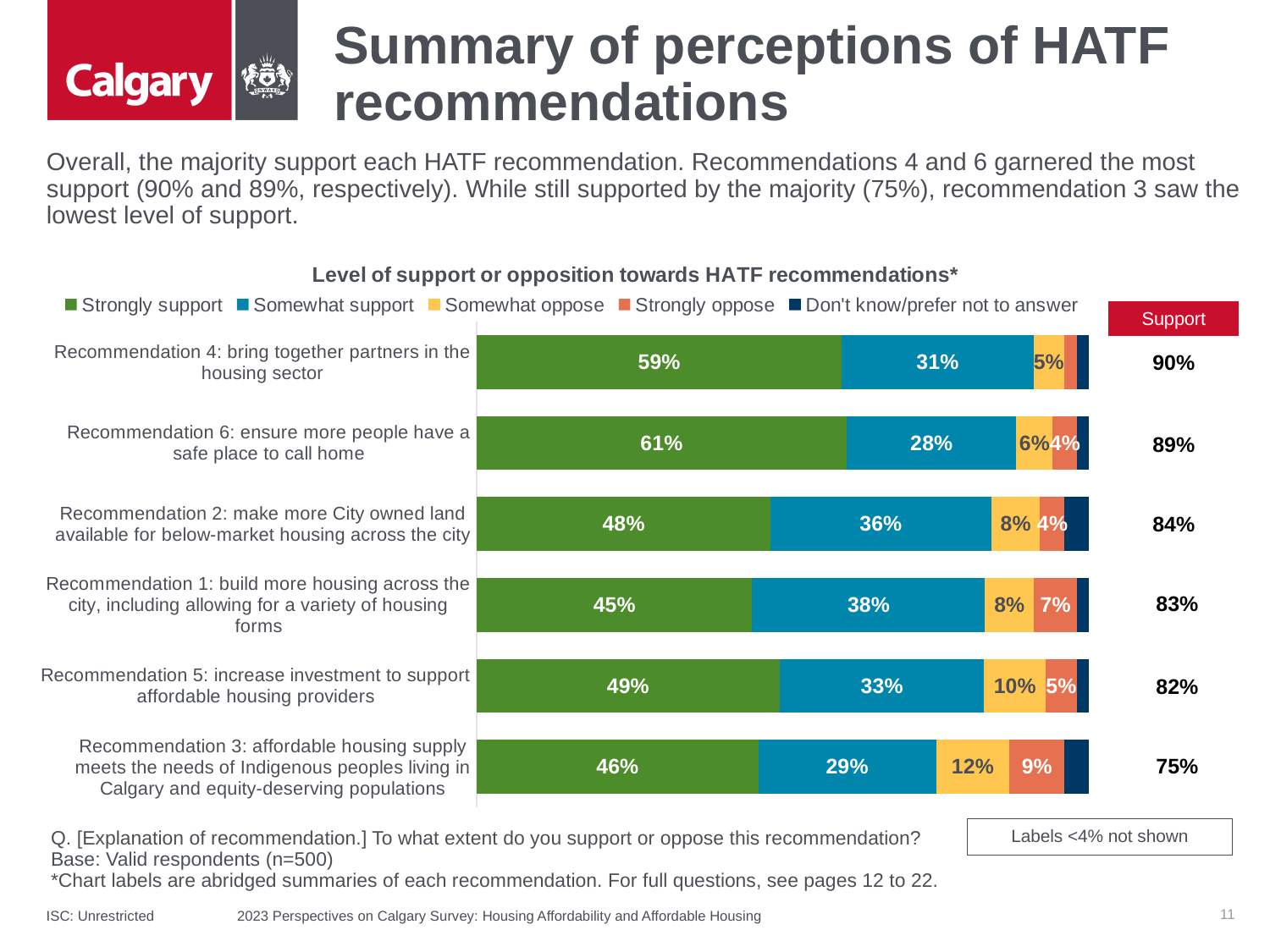
What colour represents 'Strongly support' in the chart? Green Which recommendation has the highest 'Strongly support' value? Recommendation 6 What is the 'Somewhat oppose' value for Recommendation 3? 12% Which recommendation has the lowest 'Strongly support' value? Recommendation 1 What is the combined 'Strongly support' and 'Somewhat support' total for Recommendation 5? 82% Which has a larger 'Somewhat support' value, Recommendation 2 or Recommendation 5? Recommendation 2 How many recommendations are plotted in the chart? 6 What percentage of respondents somewhat support Recommendation 1? 38% How many series does the chart legend list? 5 What percentage of respondents strongly support Recommendation 6? 61% What kind of chart is shown on the slide? Stacked bar chart What is the difference in 'Strongly support' between Recommendation 4 and Recommendation 3? 13 percentage points